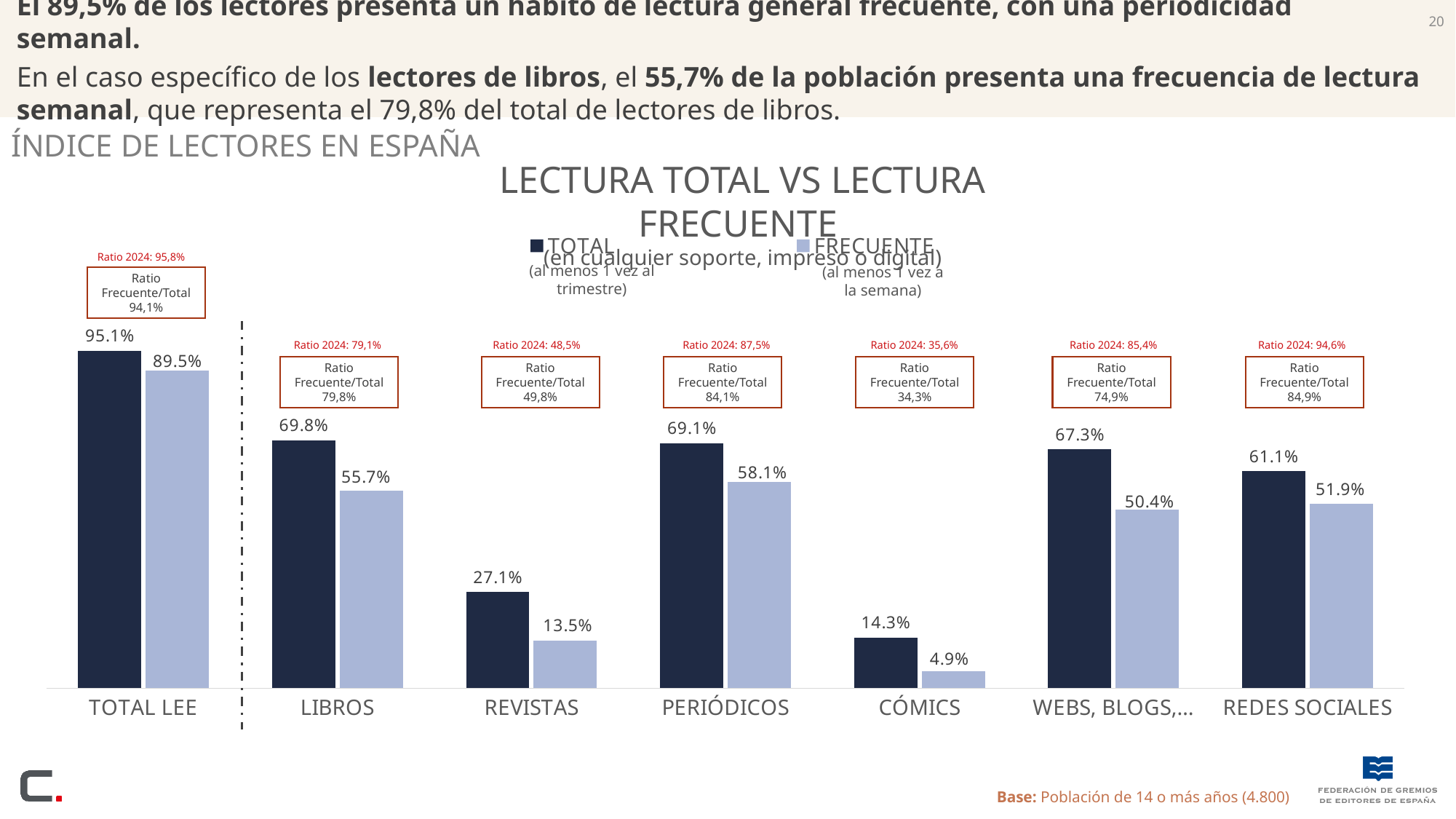
Which category has the highest FRECUENTE value? TOTAL LEE What is the difference between the TOTAL values for TOTAL LEE and WEBS, BLOGS,...? 27.8% What is the title of the chart? LECTURA TOTAL VS LECTURA FRECUENTE What is the difference between the TOTAL and FRECUENTE values for REVISTAS? 13.6% What is the TOTAL value for LIBROS? 69.8% Which category has the lowest TOTAL value? CÓMICS What kind of chart is shown on the slide? Bar chart Which is larger, the FRECUENTE value for PERIÓDICOS or the FRECUENTE value for LIBROS? PERIÓDICOS What is the FRECUENTE value for REDES SOCIALES? 51.9% How many series does the legend list? 2 What is the FRECUENTE value for CÓMICS? 4.9% How many categories are shown on the x axis of the chart? 7